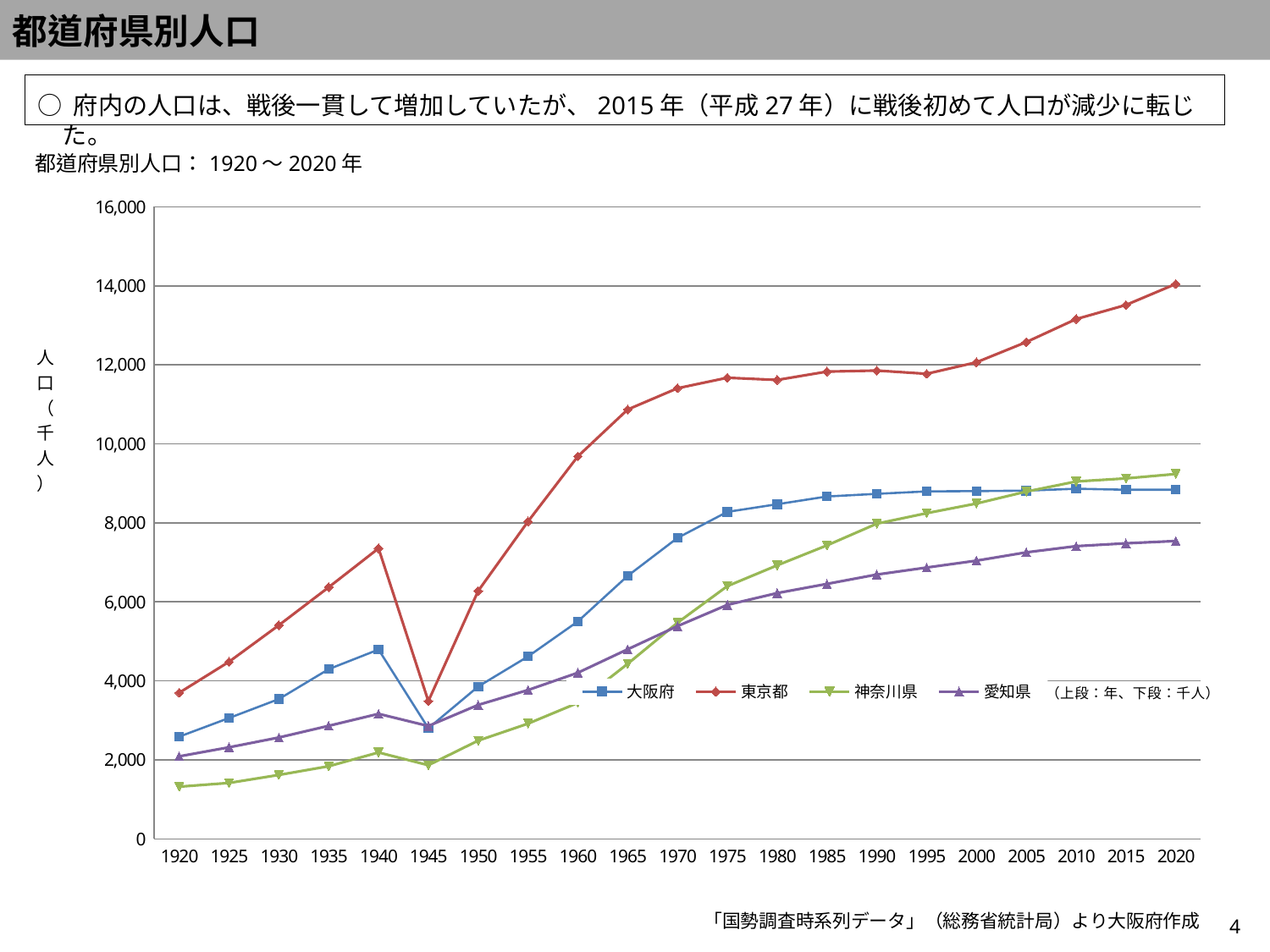
Which prefecture has the lowest population in 1920? 神奈川県 Which prefecture has the lowest population in 2020? 愛知県 How many years are marked along the x axis? 21 Is the value for 愛知県 in 2020 greater or less than 8,000? less Which prefecture has the highest population in 2020? 東京都 Is the value for 東京都 in 2020 greater or less than 12,000? greater What kind of chart is shown on the slide? line chart Is the value for 大阪府 in 1945 greater or less than 4,000? less In 2020, which is larger: the population of 神奈川県 or 大阪府? 神奈川県 What is the label on the y axis? 人口（千人） Does the population of 東京都 rise or fall between 1940 and 1945? fall How many series does the legend list? 4